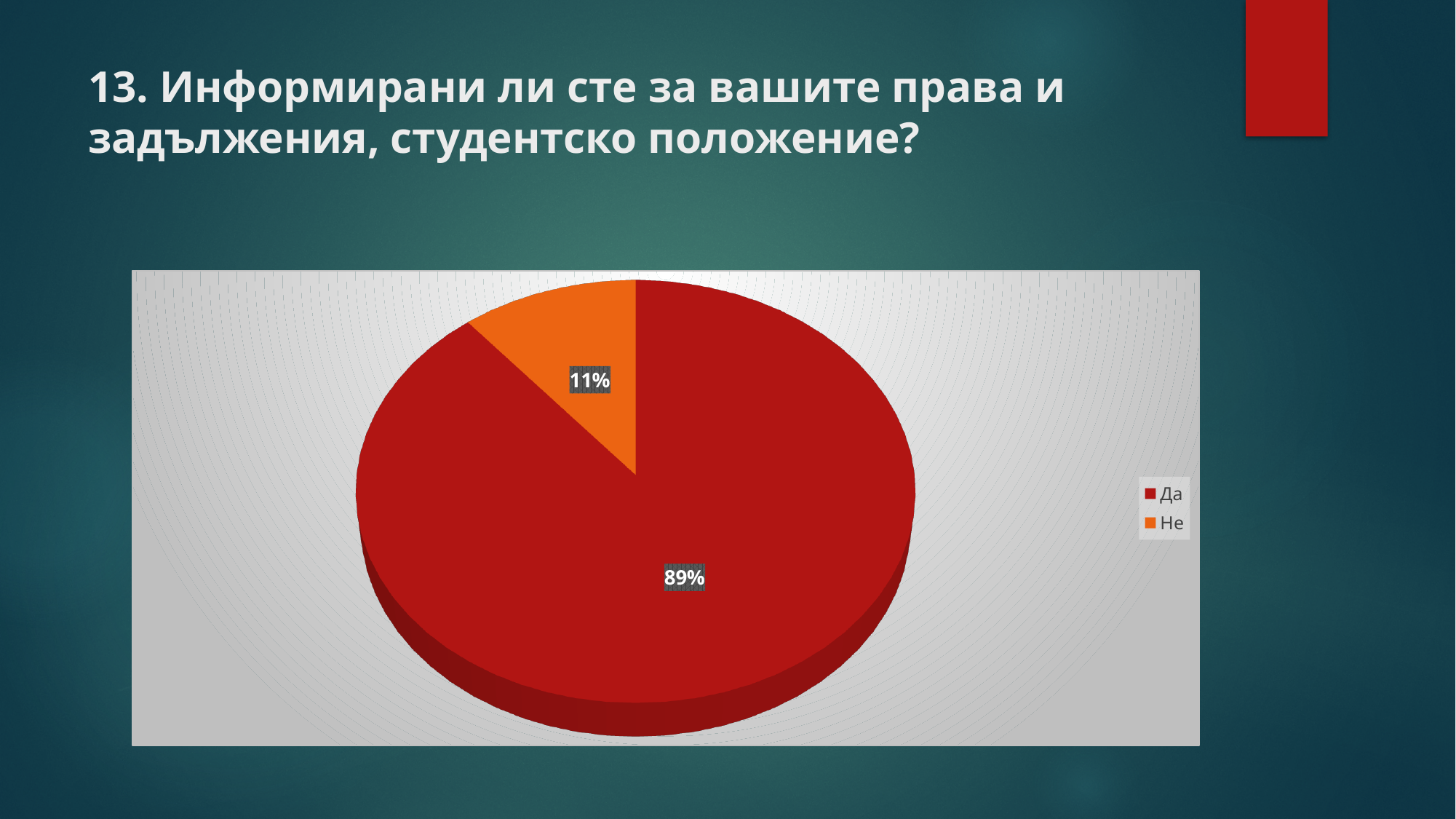
How many categories does the pie chart have? 2 Which category has the smallest slice of the pie? Не What share of the pie does the "Не" slice represent? 11% Which category has the largest slice of the pie? Да What colour is the "Не" slice? orange What kind of chart is shown on the slide? pie chart What colour is the "Да" slice? red What is the difference in percentage points between the "Да" and "Не" slices? 78 Which is larger, the "Да" slice or the "Не" slice? Да How many entries does the legend list? 2 What share of the pie does the "Да" slice represent? 89%